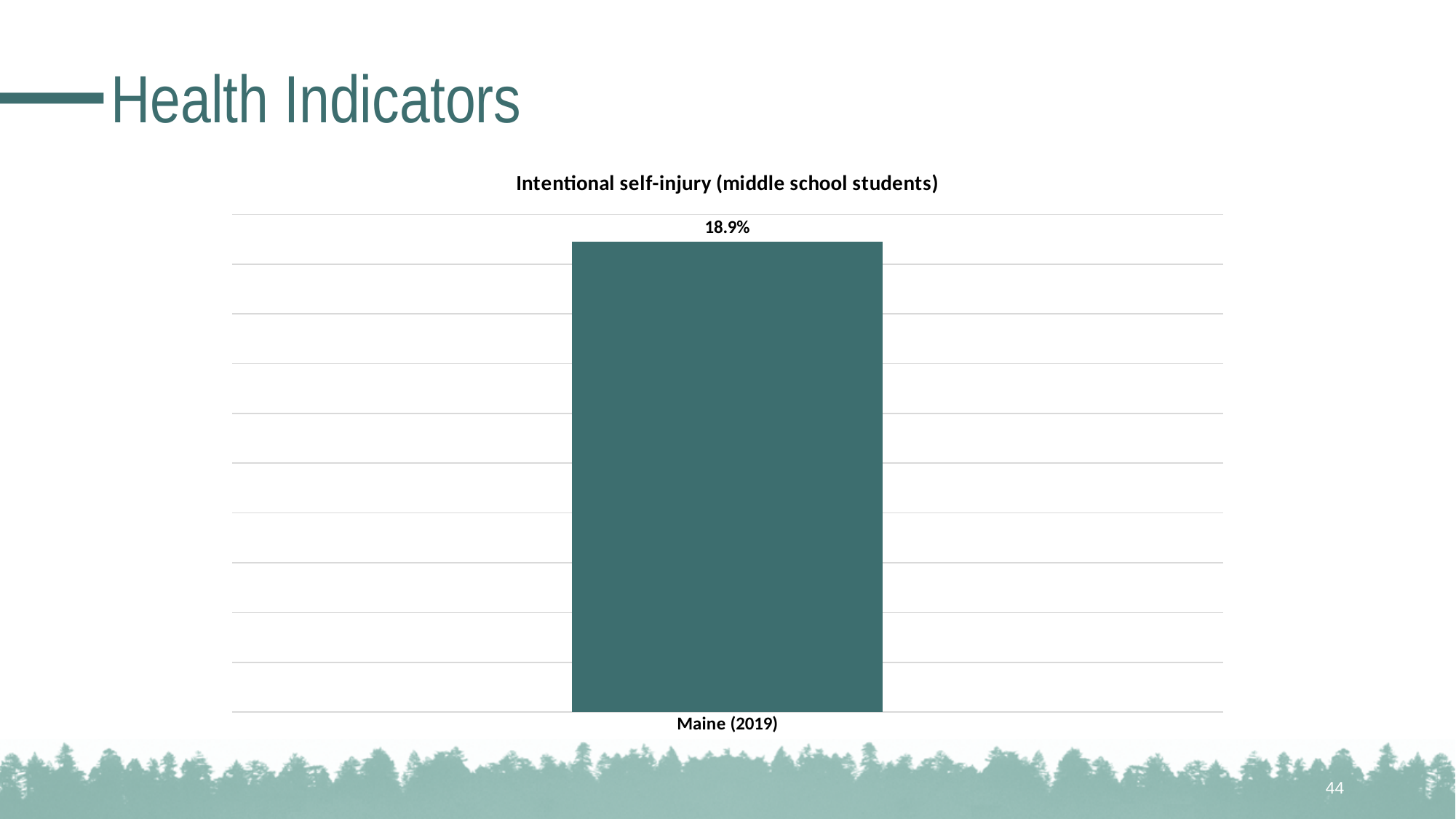
What is the value for Maine (2019) in the chart? 18.9% What is the category label on the x axis of the chart? Maine (2019) Which category has the highest value in the chart? Maine (2019) What is the title of the chart? Intentional self-injury (middle school students) How many bars does the chart show? 1 What kind of chart is shown on the slide? bar chart